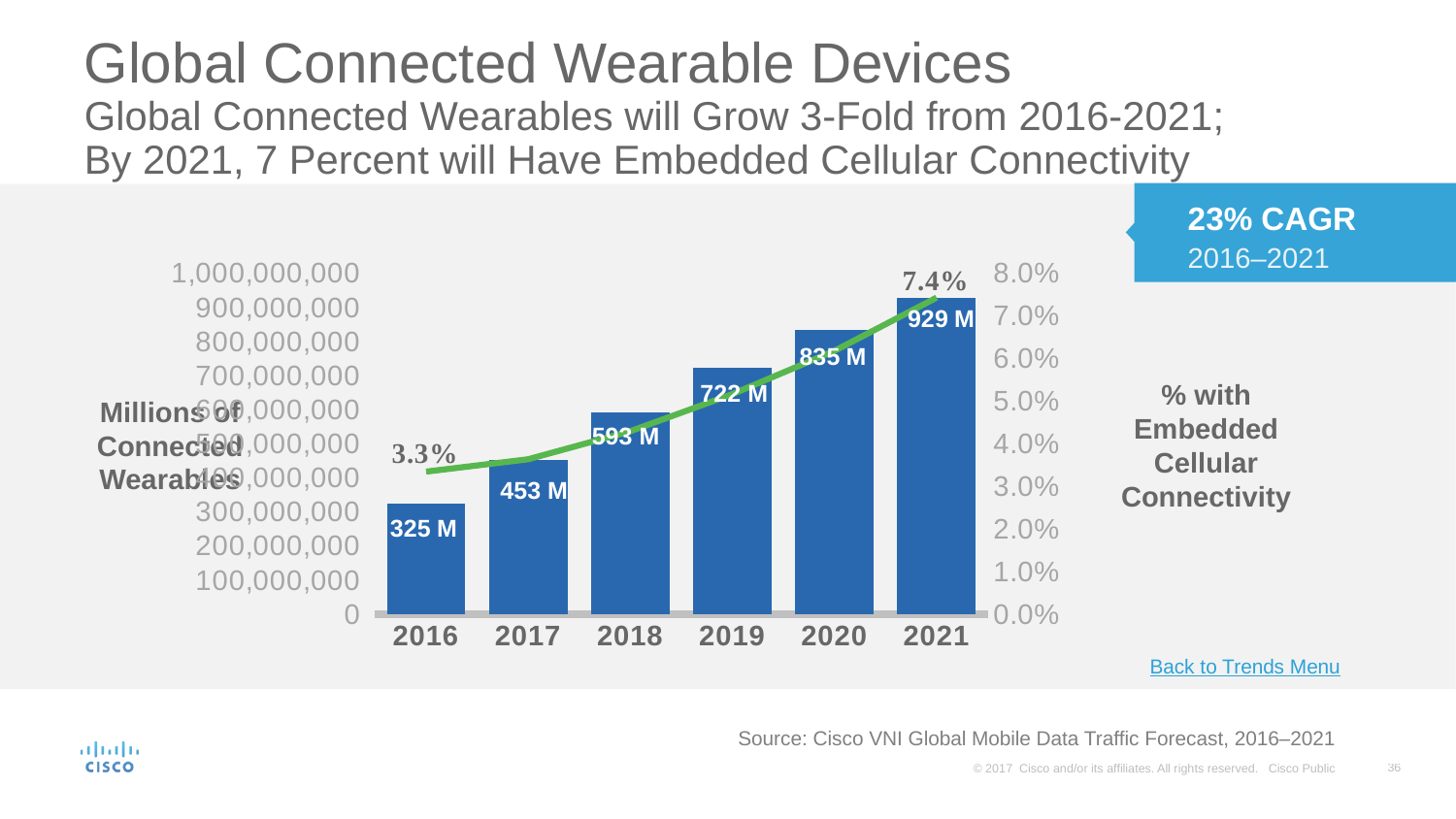
What percentage of wearables have embedded cellular connectivity in 2016? 3.3% Do the connected wearables values rise or fall from 2016 to 2021? rise What is the value for connected wearables in 2019? 722 M Which year has more connected wearables, 2018 or 2020? 2020 What percentage of wearables have embedded cellular connectivity in 2021? 7.4% Which year has the lowest number of connected wearables? 2016 What CAGR for 2016–2021 is stated on the slide? 23% CAGR What is the difference in connected wearables between 2021 and 2016? 604 M What is the value for connected wearables in 2021? 929 M Which year has the highest number of connected wearables? 2021 What is the value for connected wearables in 2016? 325 M How many years are shown on the x axis? 6